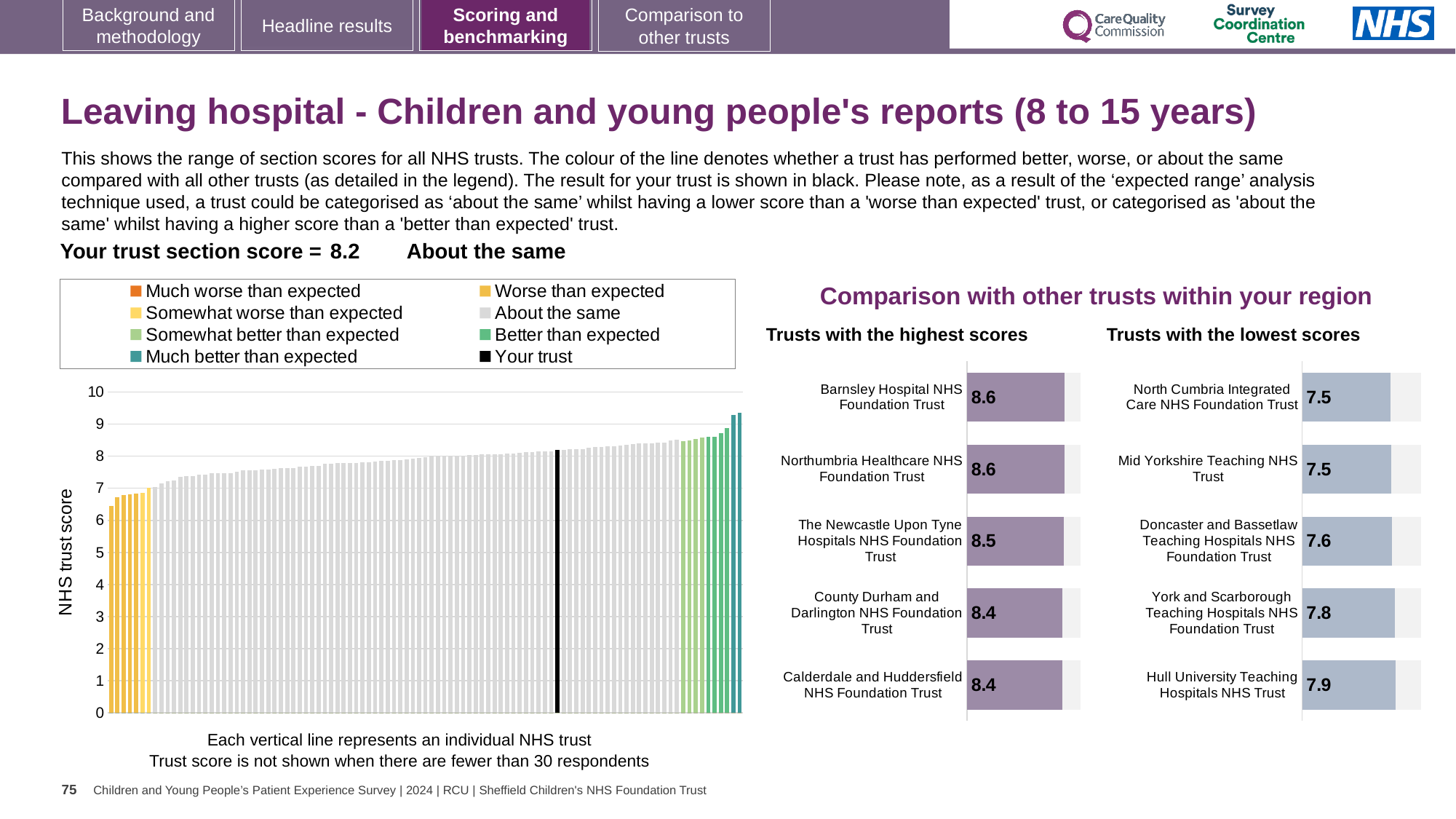
In the 'Trusts with the highest scores' chart, what is the score for The Newcastle Upon Tyne Hospitals NHS Foundation Trust? 8.5 In the 'Trusts with the lowest scores' chart, what is the difference between the scores of Hull University Teaching Hospitals NHS Trust and North Cumbria Integrated Care NHS Foundation Trust? 0.4 In the 'Trusts with the highest scores' chart, which has the larger score: The Newcastle Upon Tyne Hospitals NHS Foundation Trust or County Durham and Darlington NHS Foundation Trust? The Newcastle Upon Tyne Hospitals NHS Foundation Trust How many trusts are listed in the 'Trusts with the lowest scores' chart? 5 In the 'Trusts with the lowest scores' chart, what is the score for York and Scarborough Teaching Hospitals NHS Foundation Trust? 7.8 In the 'Trusts with the highest scores' chart, what is the difference between the scores of Barnsley Hospital NHS Foundation Trust and Calderdale and Huddersfield NHS Foundation Trust? 0.2 In the 'Trusts with the highest scores' chart, what is the score for Barnsley Hospital NHS Foundation Trust? 8.6 In the main NHS trust score chart on the left, do the bar values rise or fall from left to right? rise How many entries does the legend of the main NHS trust score chart list? 8 In the 'Trusts with the lowest scores' chart, which trust has the highest score? Hull University Teaching Hospitals NHS Trust In the main NHS trust score chart on the left, what is the section score for your trust (the black bar)? 8.2 In the main NHS trust score chart on the left, is the value of the tallest bar greater or less than 9? greater